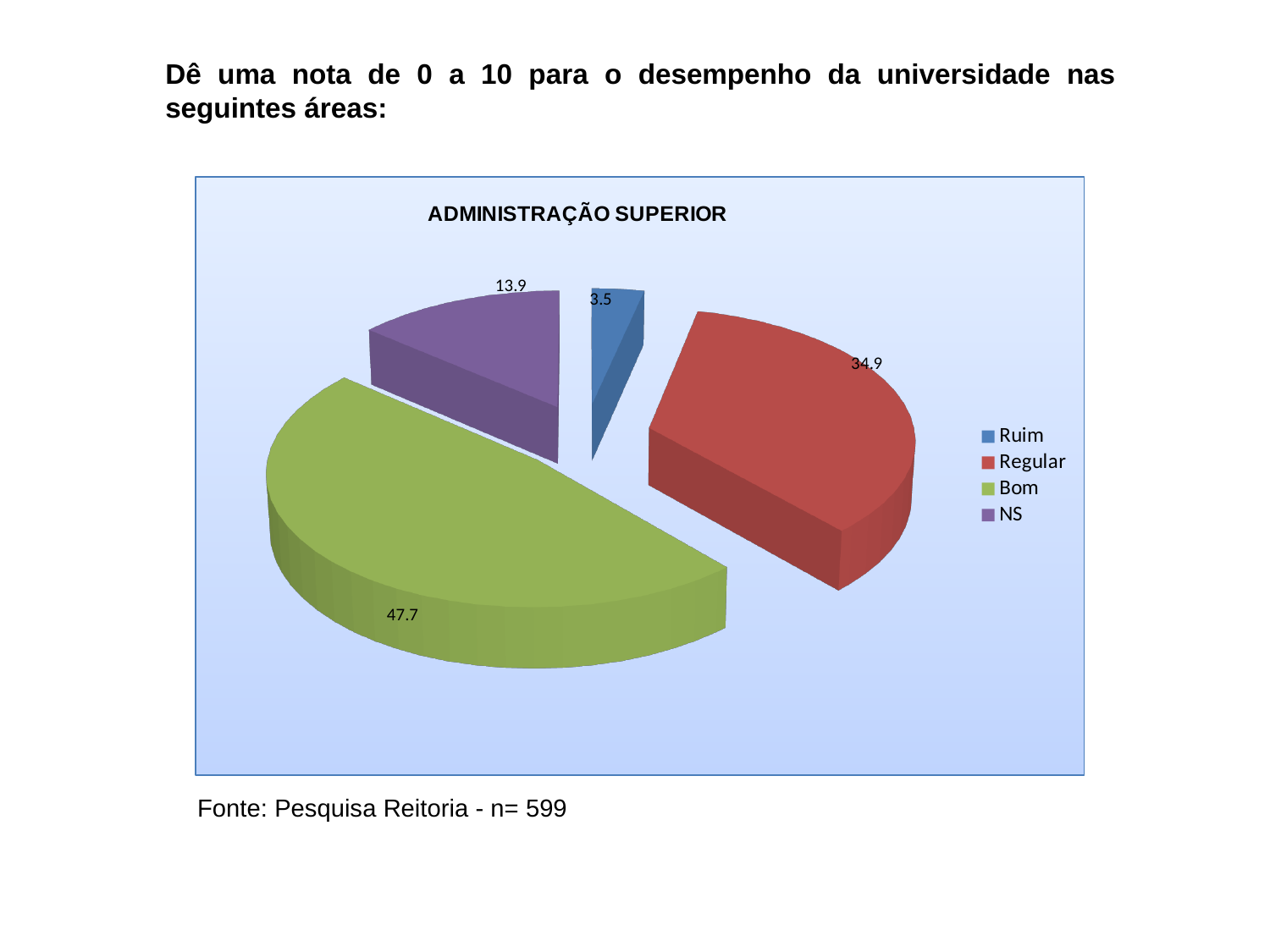
What type of chart is shown on the slide? Pie chart What is the value for Ruim? 3.5 What is the value for Regular? 34.9 What is the difference between the values for Bom and Regular? 12.8 Which category has the largest slice? Bom How many categories does the legend list? 4 What colour is the slice for Regular? Red What is the title of the chart? ADMINISTRAÇÃO SUPERIOR Which category has the smallest slice? Ruim Which is larger, the value for NS or the value for Ruim? NS What is the value for Bom? 47.7 What is the value for NS? 13.9